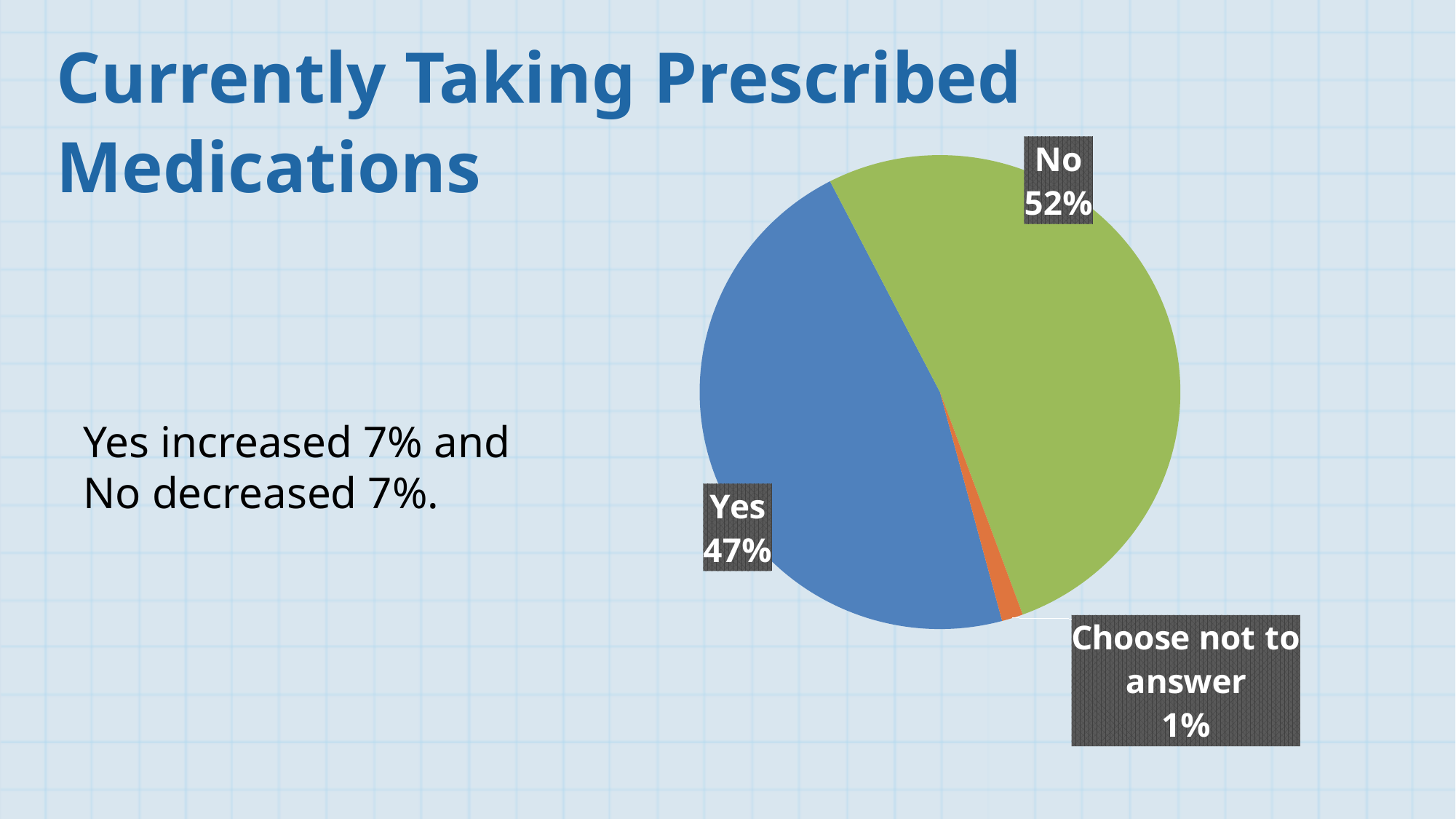
What percentage of respondents answered "Yes"? 47% What percentage of respondents chose not to answer? 1% What percentage of respondents answered "No"? 52% What kind of chart is shown on the slide? pie chart What colour is the "Yes" slice? blue Which is larger, the share for "Yes" or the share for "Choose not to answer"? Yes What share of the pie does the "No" slice represent? 52% What is the title of the slide containing the pie chart? Currently Taking Prescribed Medications How many slices does the pie chart have? 3 Which category has the smallest share of the pie? Choose not to answer Which category has the largest share of the pie? No What is the difference in percentage points between "No" and "Yes"? 5